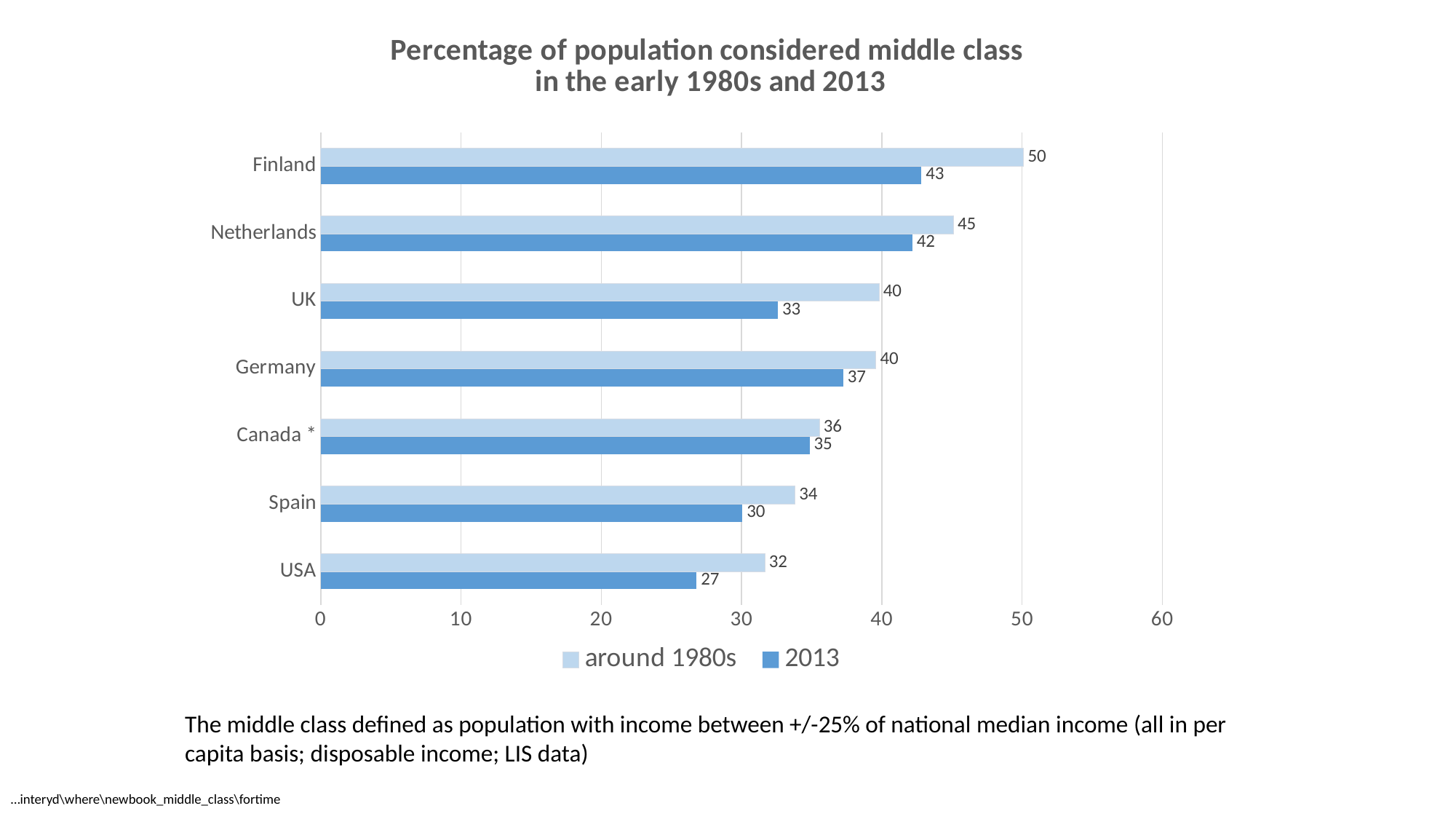
What is the value for the UK in 2013? 33 What kind of chart is shown on the slide? Bar chart Which is larger: the 2013 value for Germany or the 2013 value for Canada *? Germany What is the difference between the 'around 1980s' and 2013 values for the UK? 7 What are the two series listed in the legend? around 1980s and 2013 What is the value for the USA in 2013? 27 How many series does the legend list? 2 Which country has the lowest value in 2013? USA What is the difference between the 'around 1980s' and 2013 values for Finland? 7 What is the value for Finland in the 'around 1980s' series? 50 Which country has the highest value in the 'around 1980s' series? Finland How many countries are shown on the chart? 7